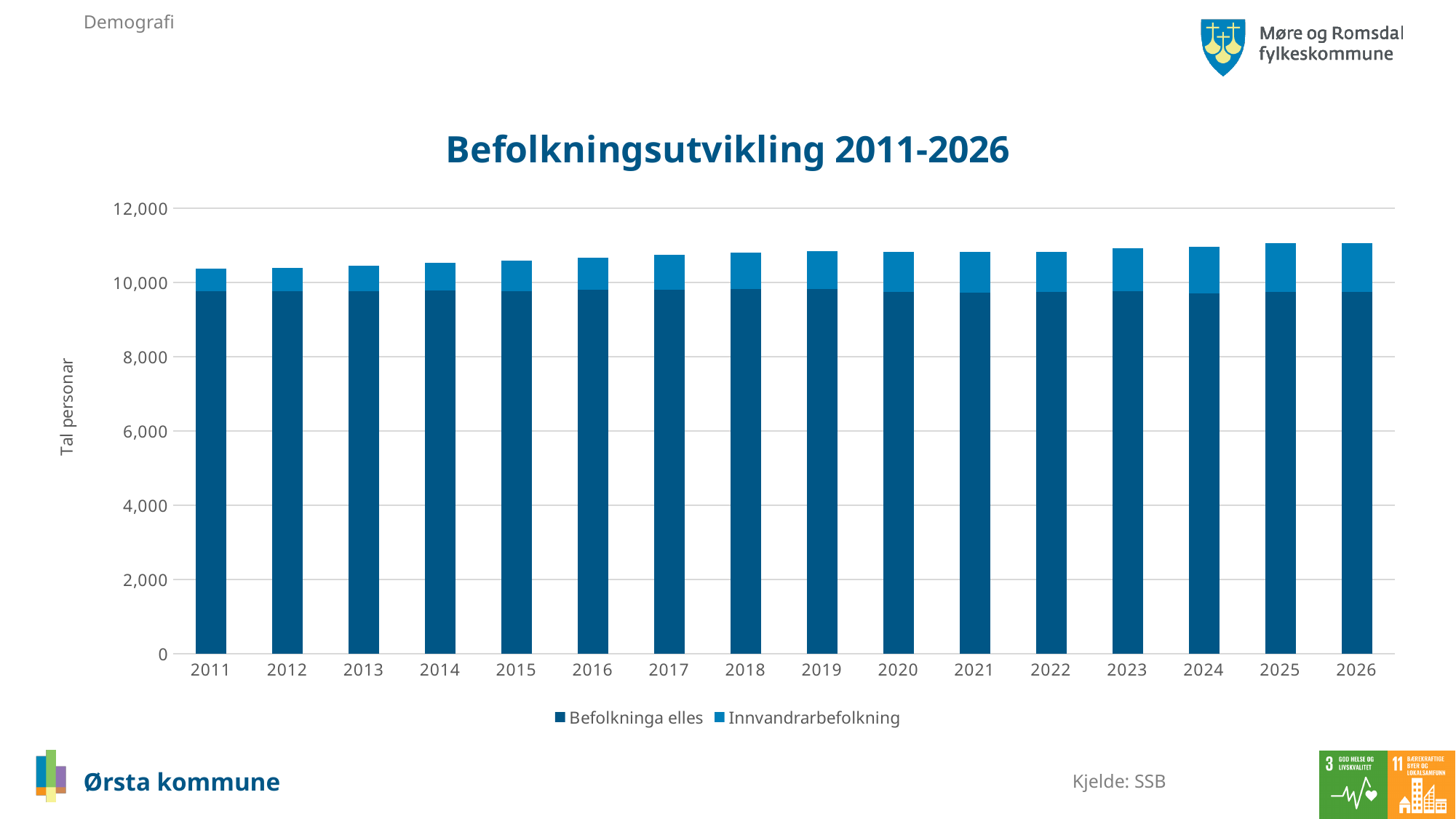
What kind of chart is shown on the slide? Stacked bar chart Is the total bar height for 2026 greater or less than 12,000? less What is the title of the chart? Befolkningsutvikling 2011-2026 Is the value for Befolkninga elles in 2026 greater or less than 8,000? greater Is the total bar height for 2011 greater or less than 10,000? greater Which two series are listed in the legend? Befolkninga elles and Innvandrarbefolkning Do the total bar heights generally rise or fall from 2011 to 2026? rise Which year has the lowest total bar height? 2011 Which is larger, the total bar for 2011 or the total bar for 2026? 2026 How many years are shown on the x axis? 16 How many series does the legend list? 2